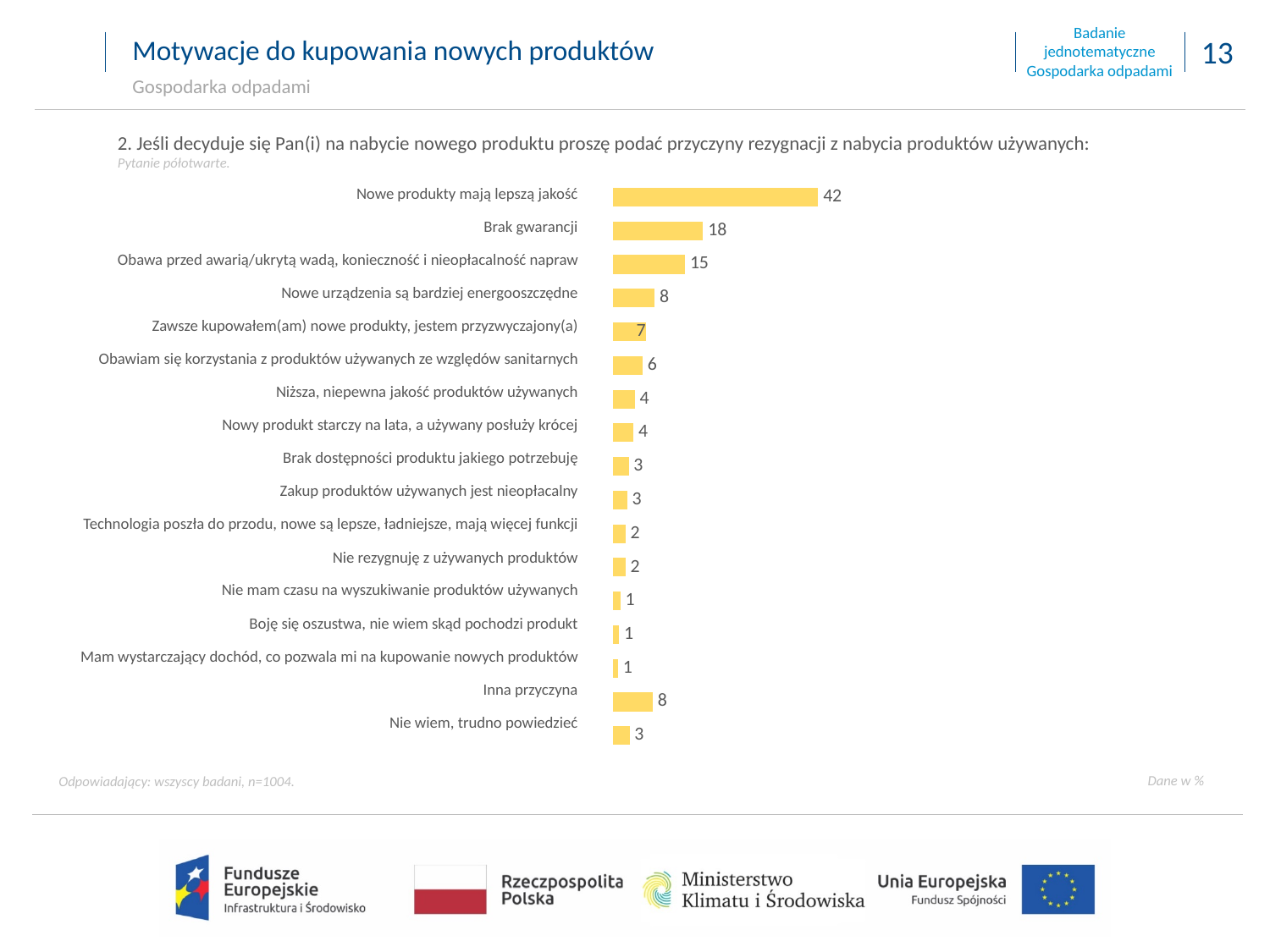
What is the value for "Nie wiem, trudno powiedzieć"? 3 What is the difference between the values for "Nowe produkty mają lepszą jakość" and "Brak gwarancji"? 24 What is the value for "Inna przyczyna"? 8 Which is larger: the value for "Brak gwarancji" or the value for "Nowe urządzenia są bardziej energooszczędne"? Brak gwarancji What kind of chart is shown on the slide? Bar chart Which category has the highest value? Nowe produkty mają lepszą jakość How many categories are shown in the chart? 17 What is the value for "Obawa przed awarią/ukrytą wadą, konieczność i nieopłacalność napraw"? 15 What is the difference between the values for "Obawa przed awarią/ukrytą wadą, konieczność i nieopłacalność napraw" and "Zawsze kupowałem(am) nowe produkty, jestem przyzwyczajony(a)"? 8 What colour are the bars in the chart? Yellow What is the value for "Brak gwarancji"? 18 What is the value for "Nowe produkty mają lepszą jakość"? 42